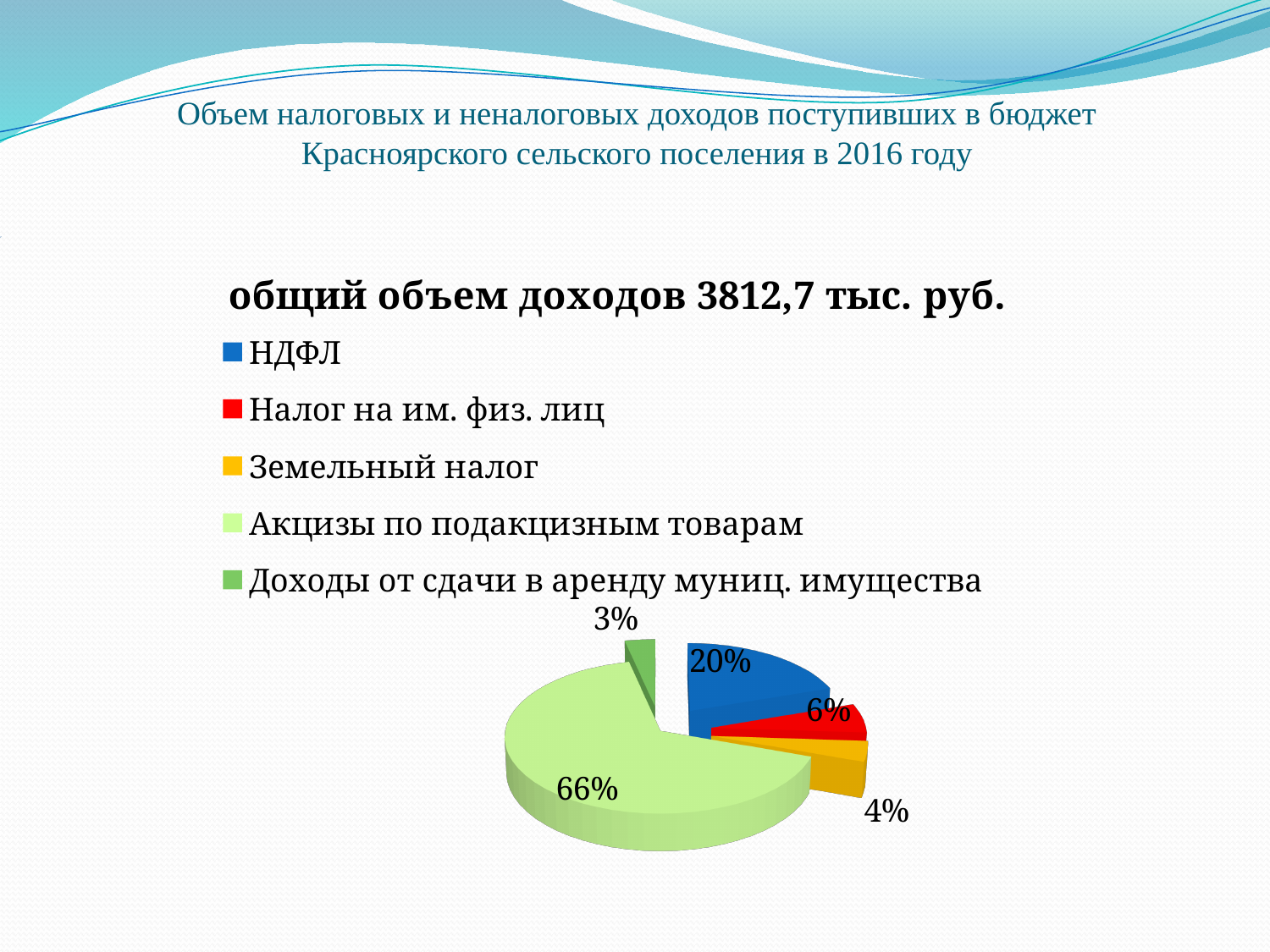
What share of the pie does Акцизы по подакцизным товарам have? 66% What is the title of the pie chart? общий объем доходов 3812,7 тыс. руб. Which category has the smallest share of the pie? Доходы от сдачи в аренду муниц. имущества What is the difference in percentage points between the share of Акцизы по подакцизным товарам and the share of НДФЛ? 46 What kind of chart is shown on the slide? pie chart How many categories does the legend of the pie chart list? 5 What share of the pie does НДФЛ have? 20% Which category has the largest share of the pie? Акцизы по подакцизным товарам What share of the pie does Налог на им. физ. лиц have? 6% Which has a larger share, НДФЛ or Налог на им. физ. лиц? НДФЛ What share of the pie does Земельный налог have? 4% What share of the pie does Доходы от сдачи в аренду муниц. имущества have? 3%